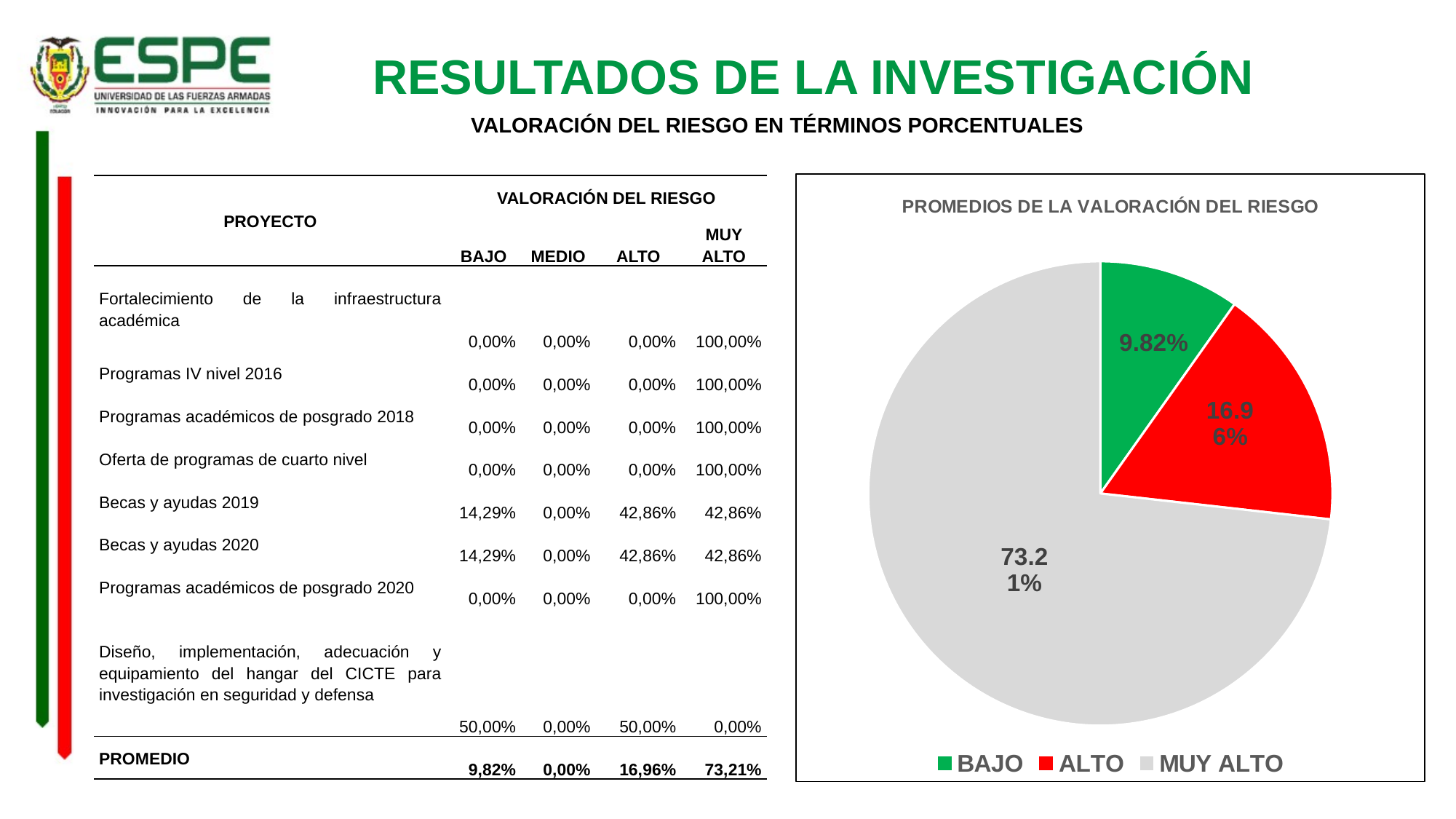
What colour is the MUY ALTO slice in the pie chart? grey In the pie chart, which slice is larger, BAJO or ALTO? ALTO How many slices does the pie chart have? 3 In the pie chart, what is the difference between the MUY ALTO and ALTO percentages? 56.25% What percentage does the MUY ALTO slice show in the pie chart? 73.21% How many entries does the legend of the pie chart list? 3 Which category has the largest slice in the pie chart? MUY ALTO What percentage does the BAJO slice show in the pie chart? 9.82% What kind of chart is shown on the slide? pie chart What is the title of the pie chart? PROMEDIOS DE LA VALORACIÓN DEL RIESGO Which category has the smallest slice in the pie chart? BAJO What percentage does the ALTO slice show in the pie chart? 16.96%